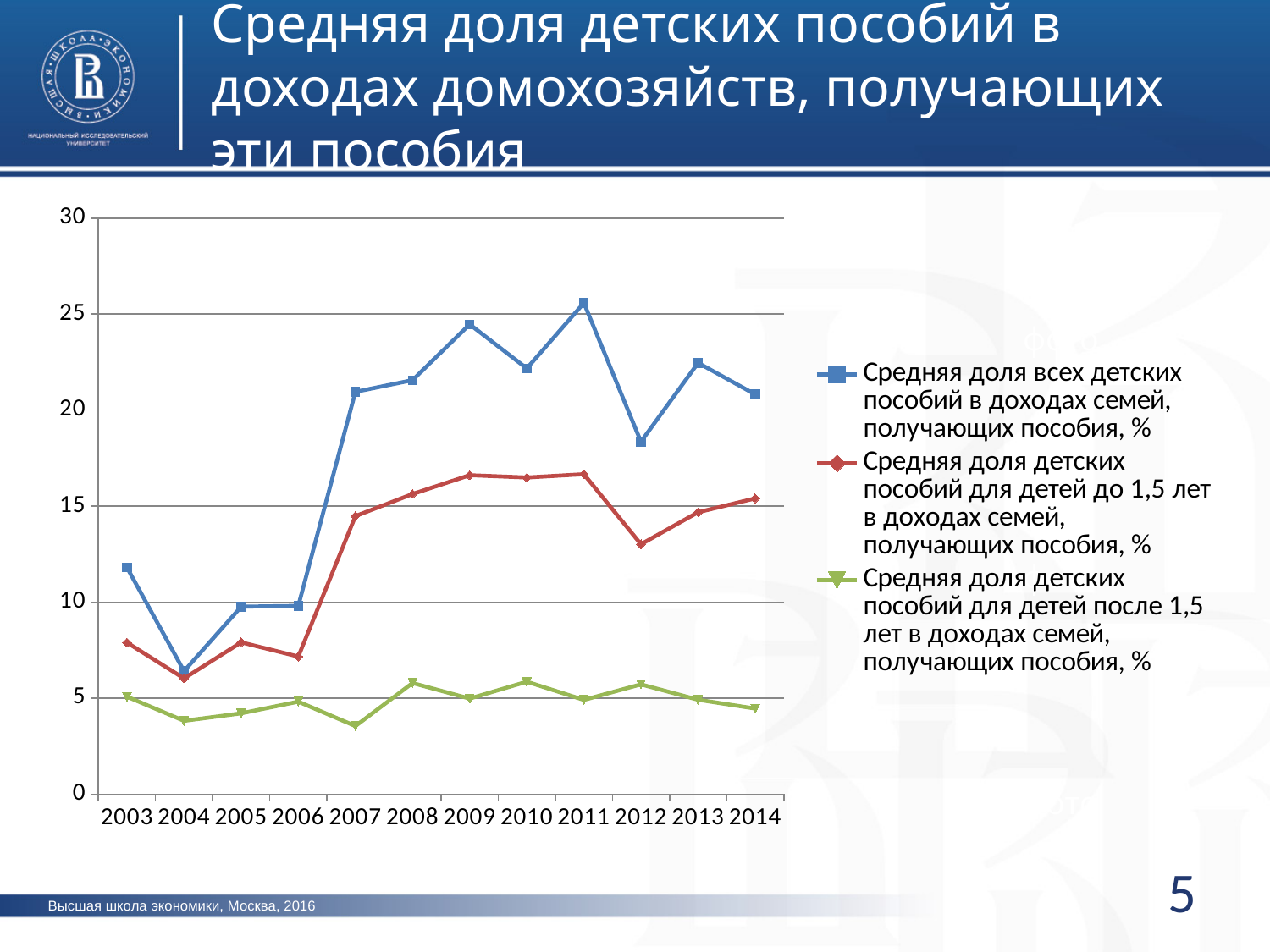
How many years are shown on the x axis? 12 Which series has the higher value in 2009: 'Средняя доля детских пособий для детей до 1,5 лет' or 'Средняя доля детских пособий для детей после 1,5 лет'? Средняя доля детских пособий для детей до 1,5 лет In which year does the series 'Средняя доля всех детских пособий в доходах семей, получающих пособия, %' have its lowest value? 2004 Between 2006 and 2007, does the series 'Средняя доля всех детских пособий в доходах семей, получающих пособия, %' rise or fall? rise Is the value for 2007 in the series 'Средняя доля детских пособий для детей после 1,5 лет в доходах семей, получающих пособия, %' greater or less than 5? less What is the first year shown on the x axis? 2003 In which year does the series 'Средняя доля всех детских пособий в доходах семей, получающих пособия, %' reach its highest value? 2011 Is the value for 2012 in the series 'Средняя доля детских пособий для детей до 1,5 лет в доходах семей, получающих пособия, %' greater or less than 15? less What kind of chart is shown on the slide? line chart What is the maximum value shown on the y axis? 30 How many series does the legend list? 3 Is the value for 2011 in the series 'Средняя доля всех детских пособий в доходах семей, получающих пособия, %' greater or less than 25? greater